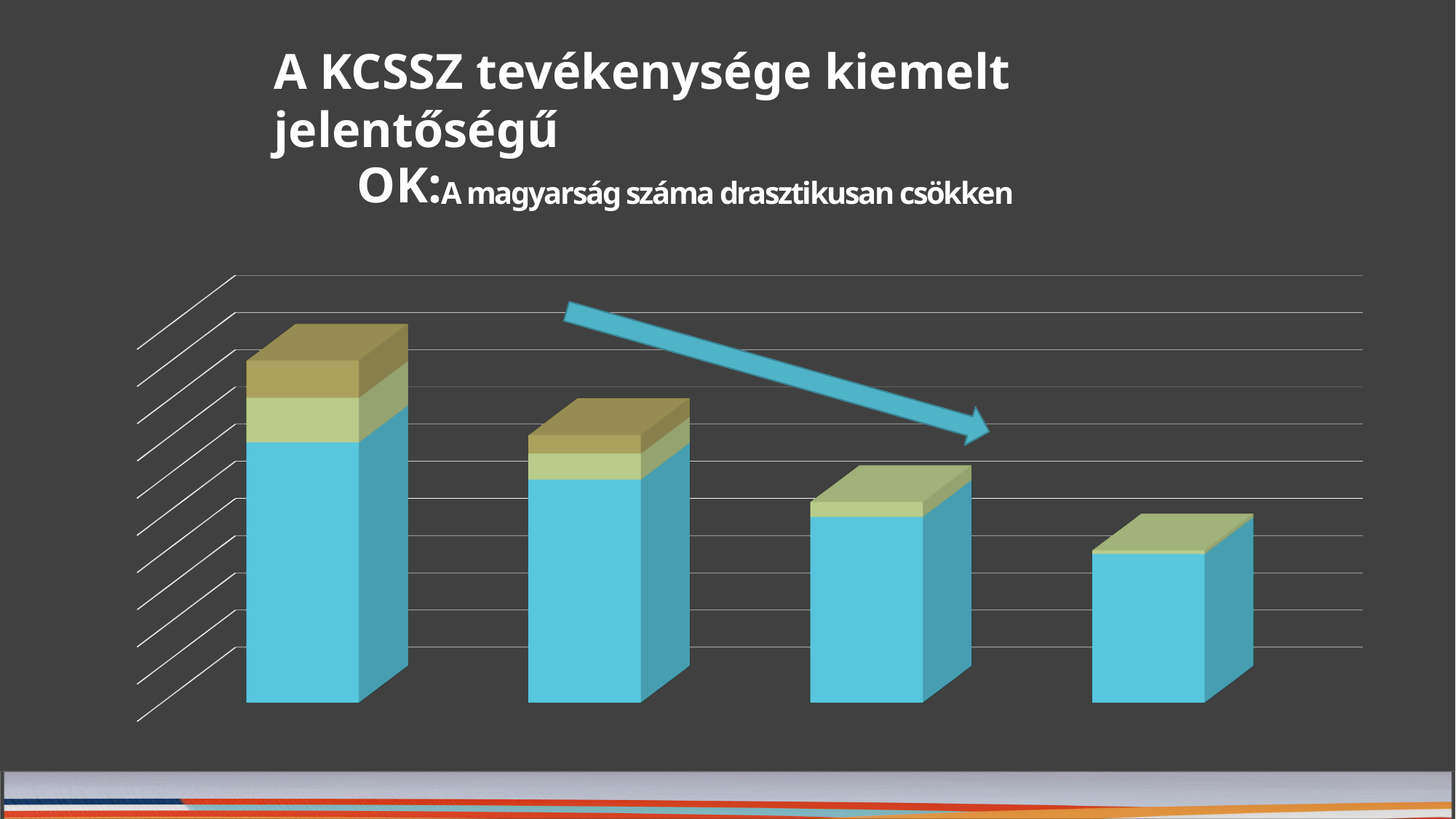
What kind of chart is shown on the slide? bar chart Does the chart display a legend? no Which bar is the tallest, the leftmost or the rightmost? leftmost Which bar is the tallest: the first, second, third or fourth from the left? first Is the second bar from the left taller or shorter than the third bar from the left? taller How many bars does the chart show? 4 Which bar is the shortest: the first, second, third or fourth from the left? fourth Do the bar heights rise or fall from left to right across the chart? fall What colour is the largest (bottom) segment of each bar? blue